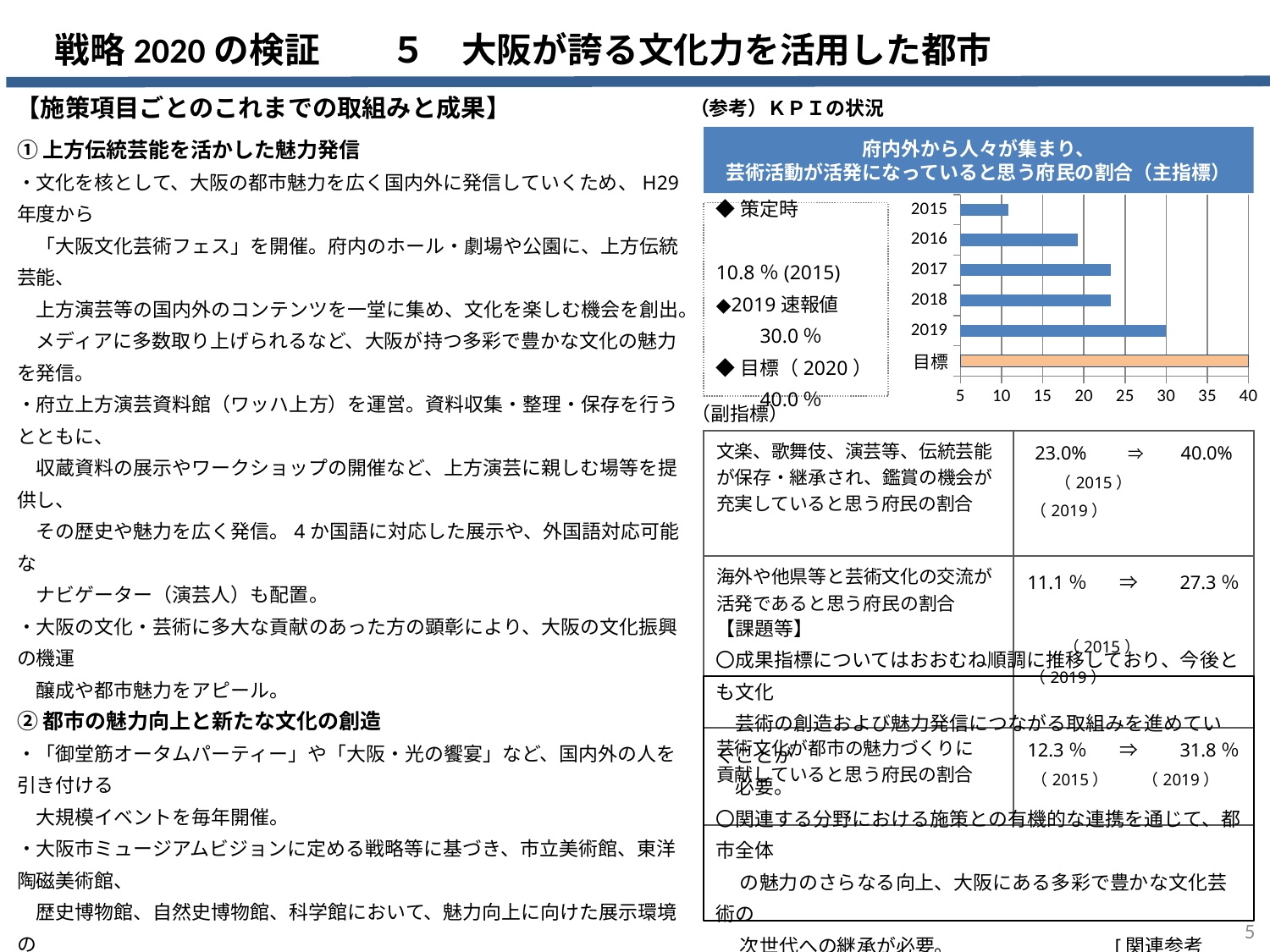
Which year has the shortest bar in the chart? 2015 Which category has the longest bar in the chart? 目標 How many categories are plotted on the bar chart's vertical axis? 6 According to the slide, what is the 2019 速報値 shown in the chart? 30.0 % Do the values generally rise or fall from 2015 to 2019? rise Is the value for 2016 greater or less than 15? greater Is the value for 2017 greater or less than 20? greater What kind of chart is shown under the KPI heading on the right of the slide? bar chart Is the value for 2018 greater or less than 25? less Which is larger, the bar for 2019 or the bar for 2016? 2019 What is the value of the 目標 (2020) bar? 40.0 % According to the slide, what is the value for 2015 (策定時)? 10.8 %